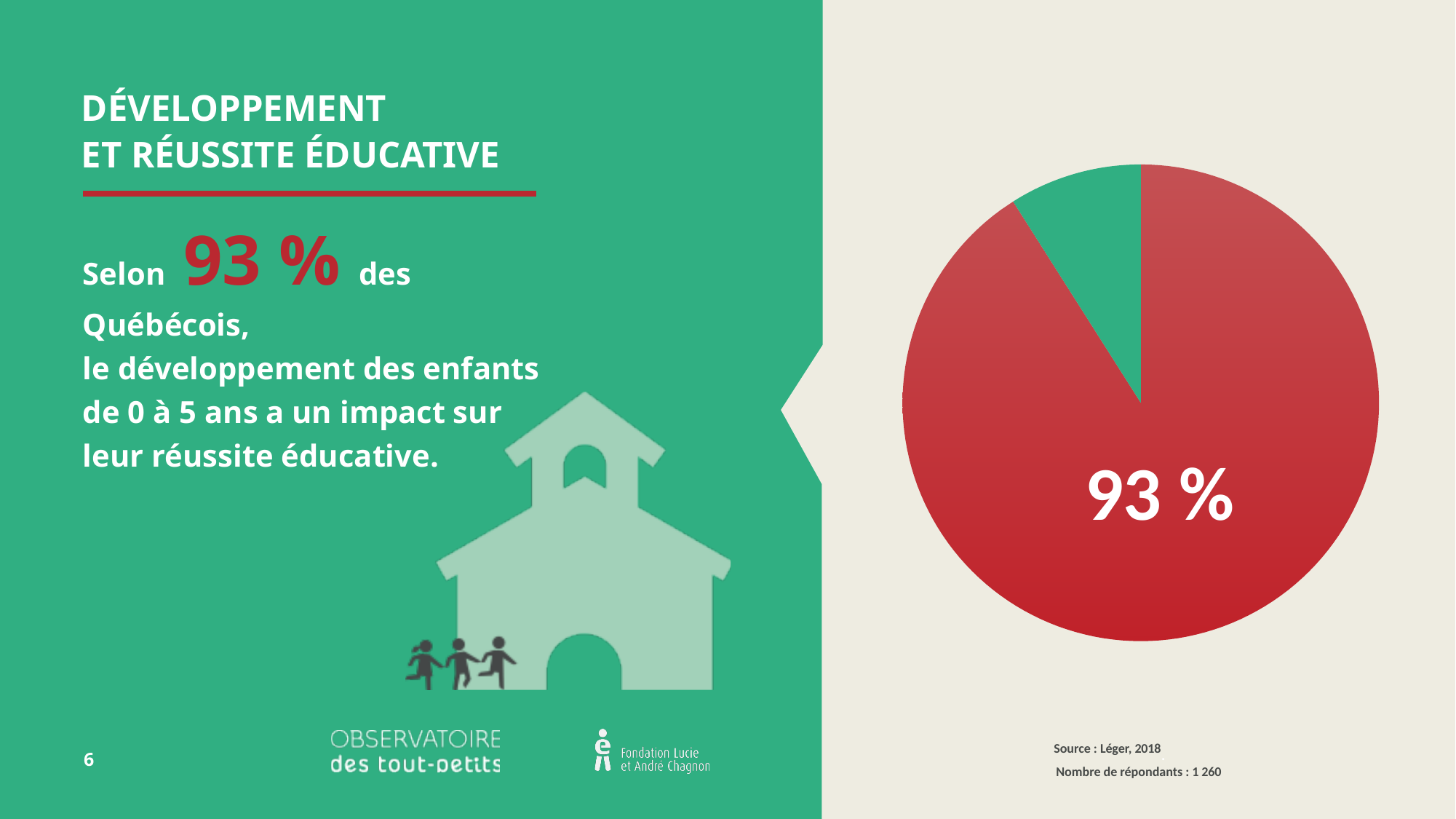
What share of the pie does the red slice represent? 93 % Is the green slice of the pie chart greater or less than 50 %? less Is the red slice of the pie chart greater or less than 50 %? greater Which slice of the pie chart is larger, the red one or the green one? the red one How many slices does the pie chart have? 2 According to the note under the pie chart, how many respondents were there? 1 260 What value is printed on the red slice of the pie chart? 93 % What kind of chart is shown on the right side of the slide? pie chart What colour is the largest slice of the pie chart? red